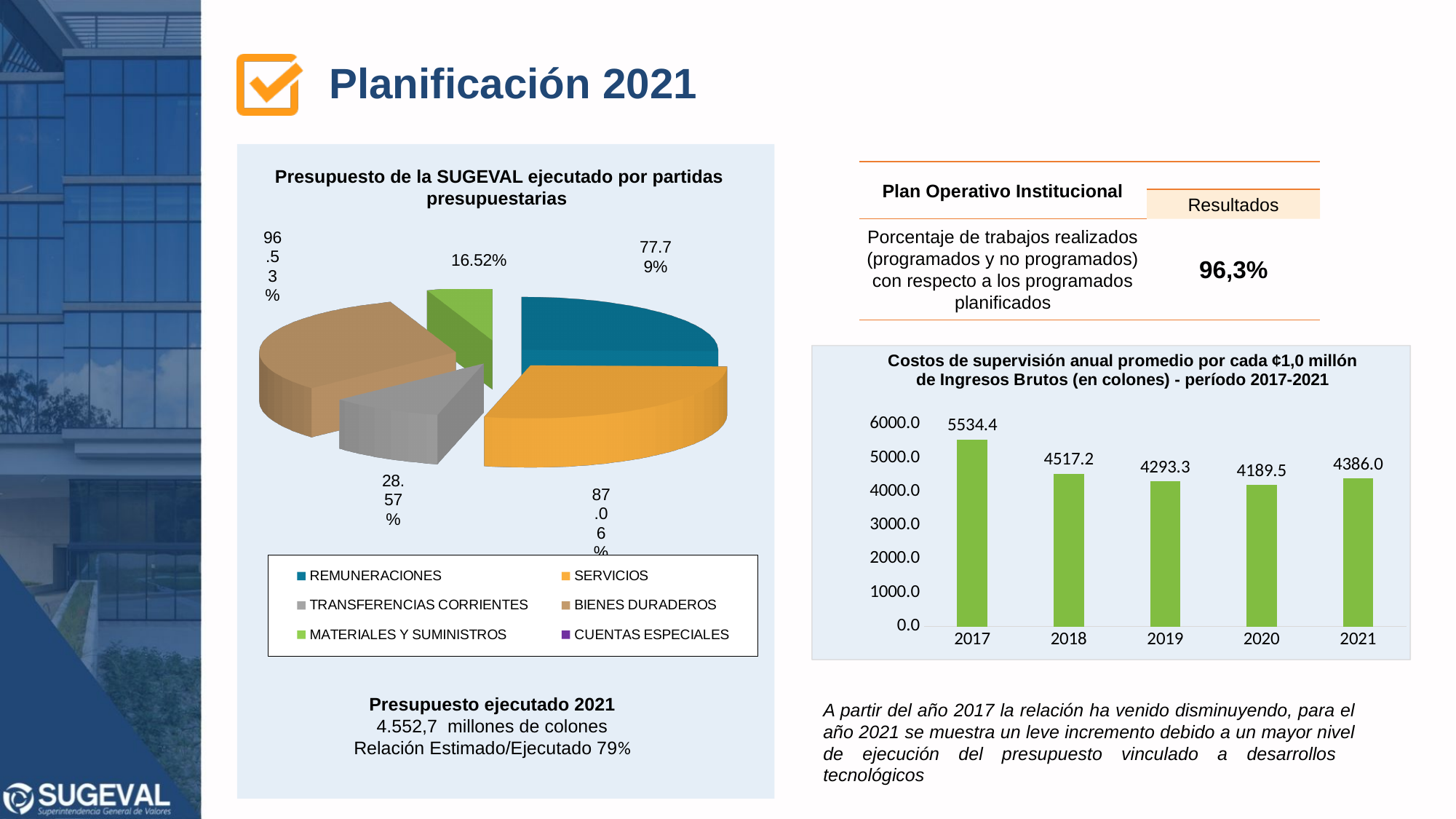
In the chart 'Costos de supervisión anual promedio por cada ¢1,0 millón de Ingresos Brutos', which year has the highest value? 2017 How many entries does the legend of the chart 'Presupuesto de la SUGEVAL ejecutado por partidas presupuestarias' list? 6 In the chart 'Costos de supervisión anual promedio por cada ¢1,0 millón de Ingresos Brutos', what is the value for 2017? 5534.4 What kind of chart is 'Costos de supervisión anual promedio por cada ¢1,0 millón de Ingresos Brutos'? Bar chart In the chart 'Costos de supervisión anual promedio por cada ¢1,0 millón de Ingresos Brutos', how do the values change from 2017 to 2020? They fall each year In the chart 'Costos de supervisión anual promedio por cada ¢1,0 millón de Ingresos Brutos', which year has the lowest value? 2020 In the chart 'Costos de supervisión anual promedio por cada ¢1,0 millón de Ingresos Brutos', is the value for 2019 larger than the value for 2020? Yes, 2019 (4293.3) is larger than 2020 (4189.5) In the chart 'Costos de supervisión anual promedio por cada ¢1,0 millón de Ingresos Brutos', how many years are shown? 5 What kind of chart is 'Presupuesto de la SUGEVAL ejecutado por partidas presupuestarias'? Pie chart In the chart 'Costos de supervisión anual promedio por cada ¢1,0 millón de Ingresos Brutos', what is the value for 2021? 4386.0 In the chart 'Costos de supervisión anual promedio por cada ¢1,0 millón de Ingresos Brutos', what is the difference between the 2017 and 2018 values? 1017.2 In the chart 'Presupuesto de la SUGEVAL ejecutado por partidas presupuestarias', which colour represents SERVICIOS in the legend? Orange